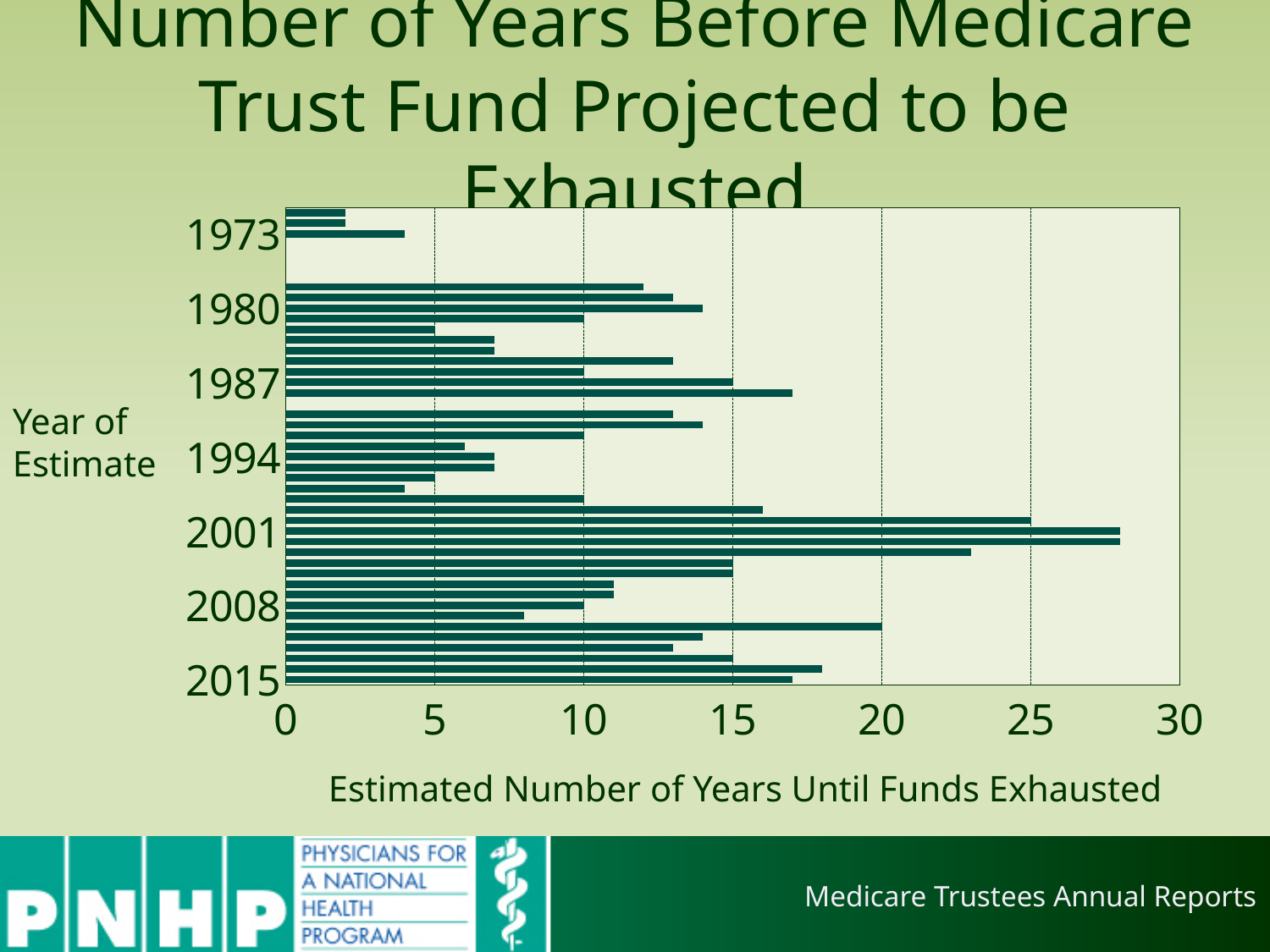
Which has the larger value, 2001 or 2015? 2001 Do the bar values rise or fall moving from 1994 to 2001? rise Which labeled year of estimate has the longest bar? 2001 What kind of chart is shown on the slide? bar chart Is the value for 1980 greater or less than 10? greater Is the value for 1994 greater or less than 10? less How many year labels are shown on the vertical axis of the chart? 7 What source is cited at the bottom of the slide for the chart data? Medicare Trustees Annual Reports What is the title of the horizontal axis of the chart? Estimated Number of Years Until Funds Exhausted Which labeled year of estimate has the shortest bar? 1973 Is the value for 2001 greater or less than 25? greater